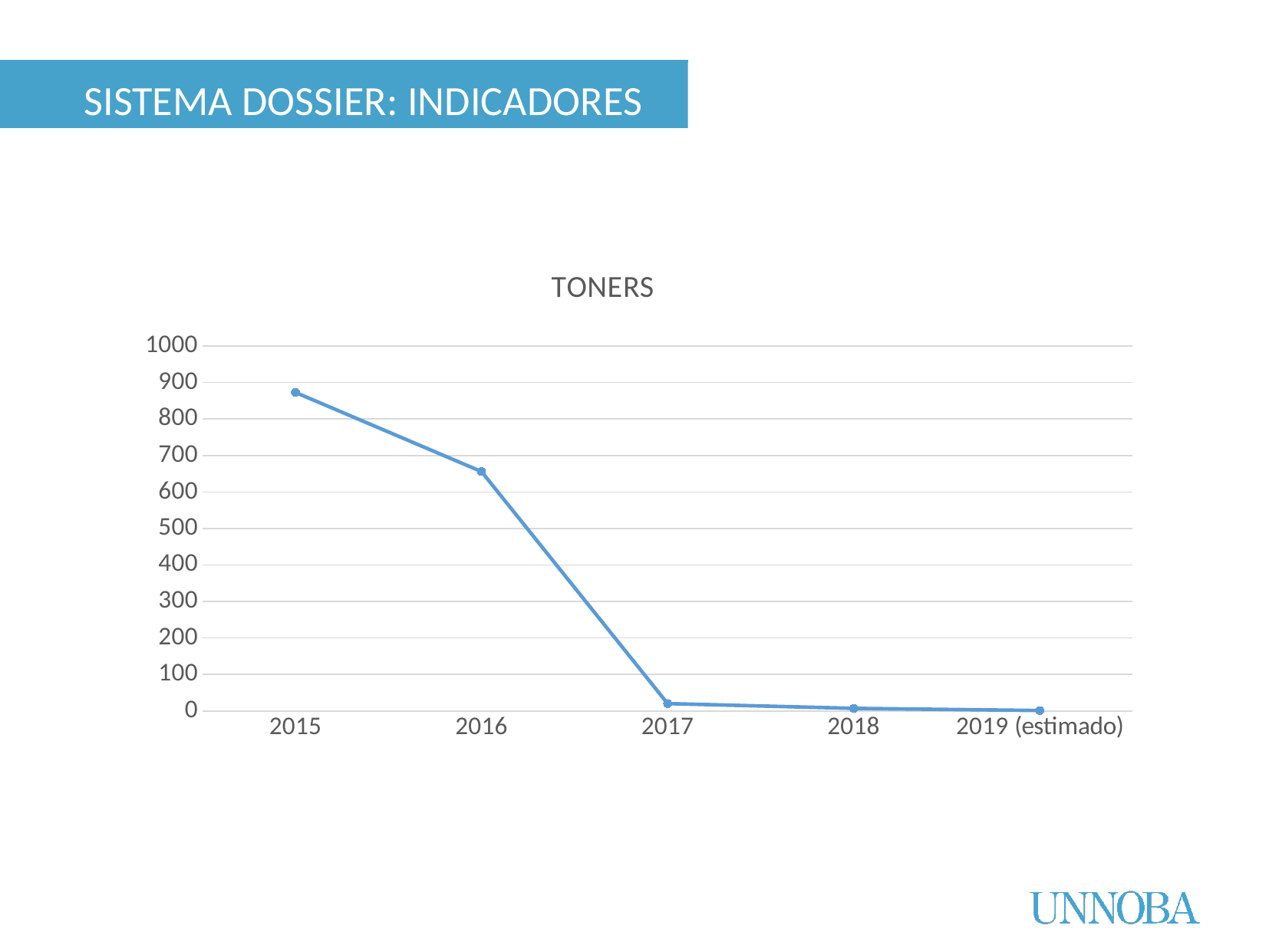
What is the title of the chart? TONERS Which year has the highest value? 2015 Do the values rise or fall from 2015 to 2019 (estimado)? fall How many data points are plotted on the line? 5 What is the label of the last category on the x axis? 2019 (estimado) Which is larger, the value for 2016 or the value for 2017? 2016 Which year has the lowest value? 2019 (estimado) Is the value for 2016 greater or less than 600? greater Is the value for 2016 greater or less than 700? less Is the value for 2015 greater or less than 800? greater What kind of chart is shown on the slide? line chart